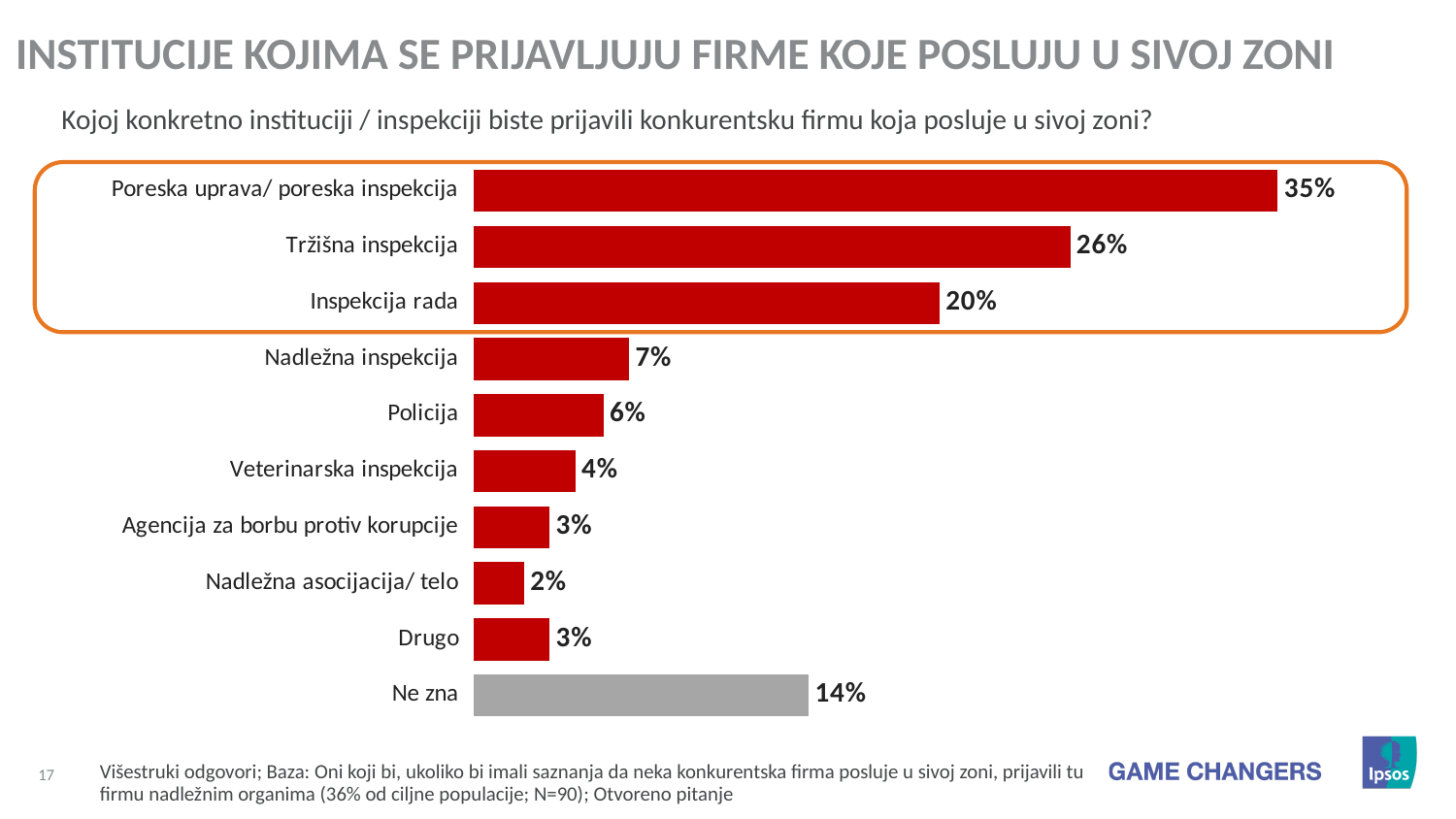
What is the value for Poreska uprava/ poreska inspekcija? 35% What is the value for Tržišna inspekcija? 26% Which category has the highest value? Poreska uprava/ poreska inspekcija What kind of chart is shown on the slide? Bar chart What is the difference between the values for Poreska uprava/ poreska inspekcija and Inspekcija rada? 15% Which category has the lowest value? Nadležna asocijacija/ telo What is the difference between the values for Tržišna inspekcija and Ne zna? 12% Which is larger, the value for Nadležna inspekcija or the value for Policija? Nadležna inspekcija Which category's bar is coloured grey instead of red? Ne zna How many categories are shown in the chart? 10 What is the value for Ne zna? 14% What is the value for Veterinarska inspekcija? 4%